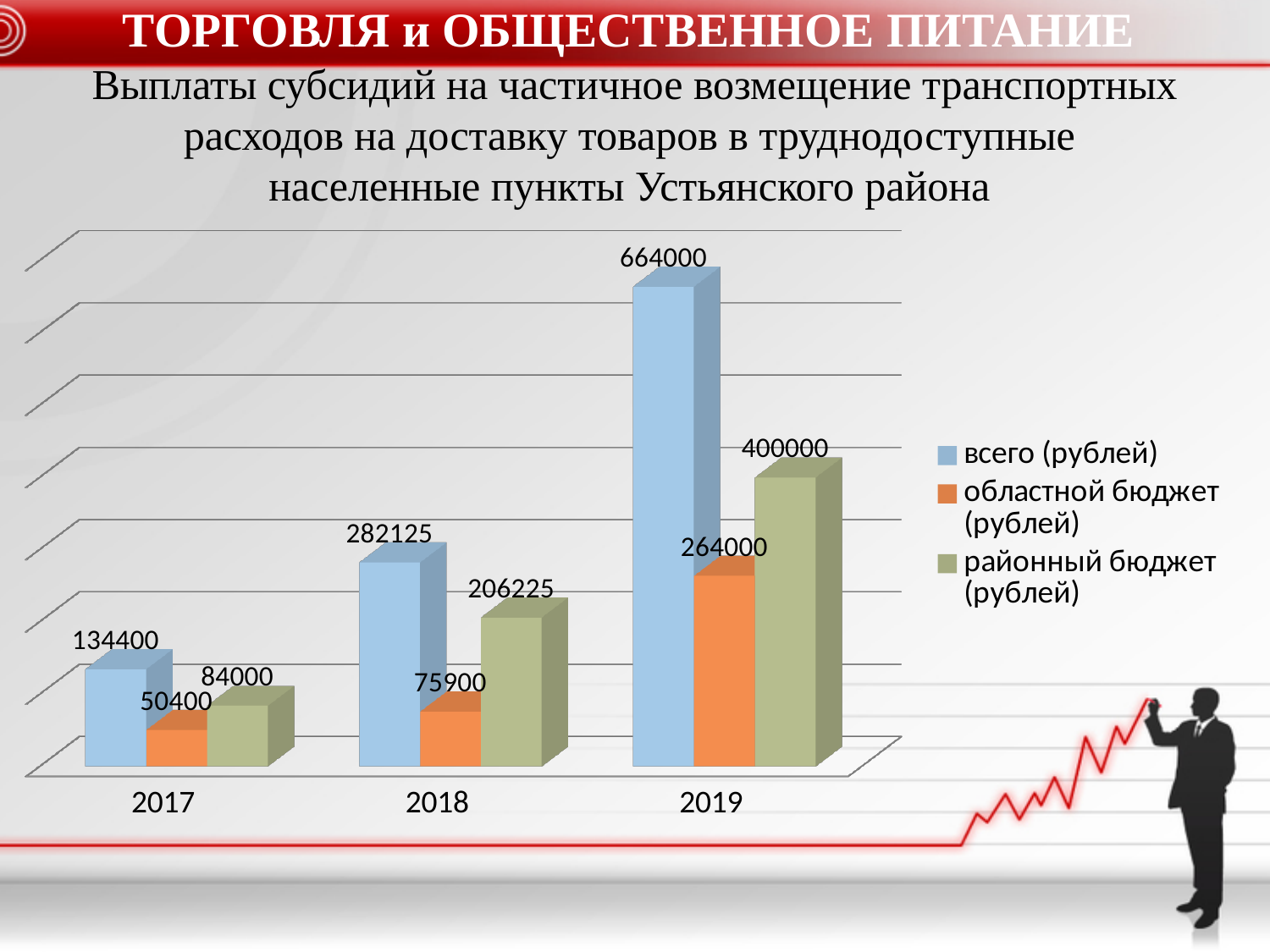
What is the value of областной бюджет (рублей) for 2019? 264000 In which year is областной бюджет (рублей) the lowest? 2017 What is the value of областной бюджет (рублей) for 2017? 50400 What is the value of районный бюджет (рублей) for 2018? 206225 How many series does the legend list? 3 Which is larger in 2018: областной бюджет (рублей) or районный бюджет (рублей)? районный бюджет (рублей) What kind of chart is shown on the slide? bar chart In which year is всего (рублей) the highest? 2019 What is the value of всего (рублей) for 2019? 664000 What is the difference between всего (рублей) in 2019 and in 2018? 381875 How many years are shown on the x axis? 3 Does всего (рублей) rise or fall from 2017 to 2019? rise